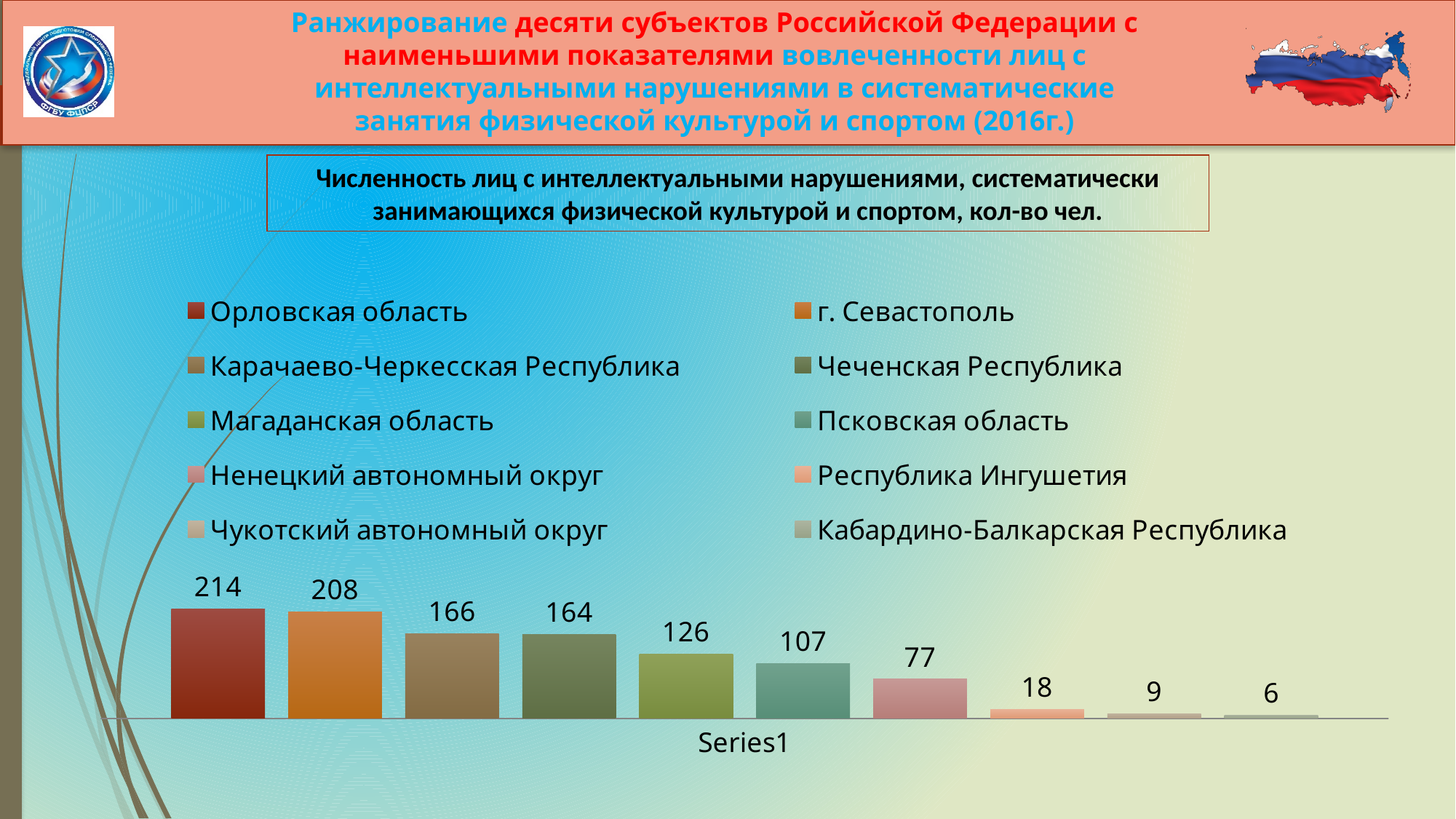
What is the value for Чеченская Республика? 164 What is the difference between the values for Магаданская область and Ненецкий автономный округ? 49 What is the value for Псковская область? 107 Which is larger, the value for Карачаево-Черкесская Республика or the value for Республика Ингушетия? Карачаево-Черкесская Республика What is the value for Орловская область? 214 What is the value for Кабардино-Балкарская Республика? 6 How many bars are plotted in the chart? 10 Which region has the lowest value in the chart? Кабардино-Балкарская Республика How many entries does the chart legend list? 10 What is the value for г. Севастополь? 208 What type of chart is shown on the slide? bar chart Which region has the highest value in the chart? Орловская область